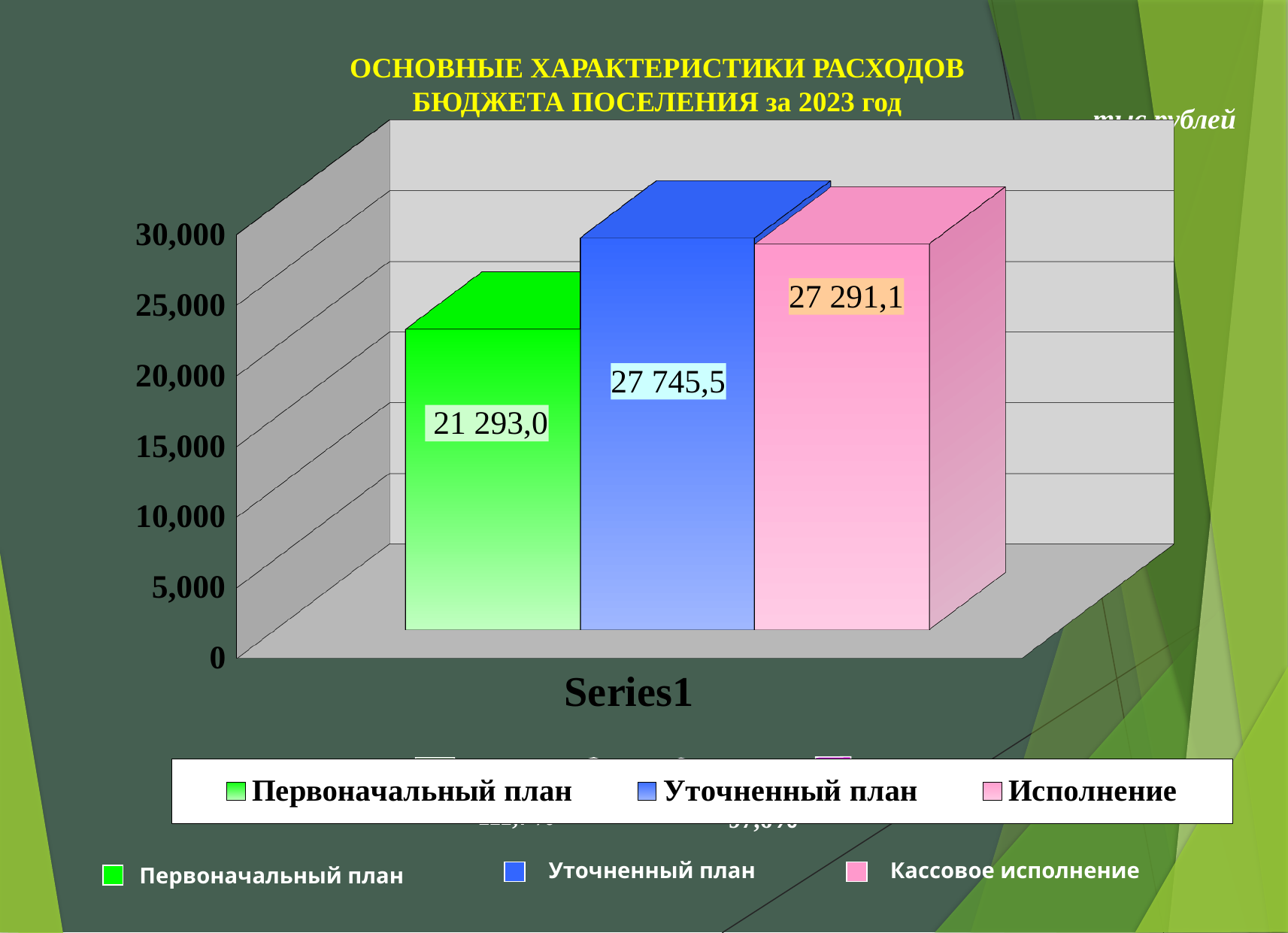
What colour is the bar for Исполнение? pink Which is larger, Уточненный план or Исполнение? Уточненный план What is the value for Первоначальный план? 21 293,0 What is the difference between Уточненный план and Исполнение? 454,4 What is the value for Исполнение? 27 291,1 What is the difference between Уточненный план and Первоначальный план? 6 452,5 How many series does the legend list? 3 Which series has the highest value? Уточненный план What is the value for Уточненный план? 27 745,5 Which series has the lowest value? Первоначальный план What kind of chart is shown on the slide? bar chart Is the value for Первоначальный план greater or less than 20,000? greater